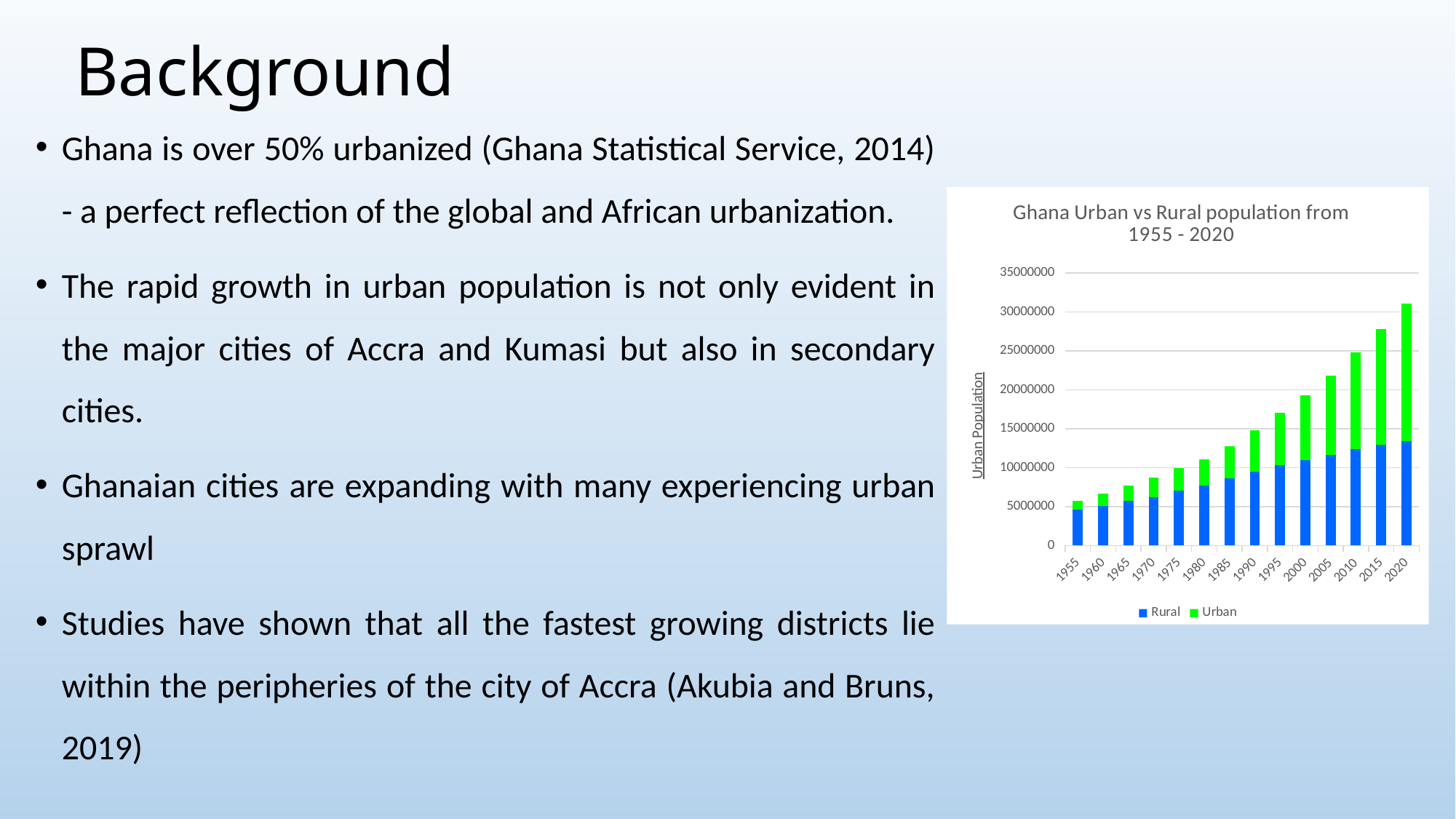
Which year has the highest total population bar in the chart? 2020 What is the title of the chart? Ghana Urban vs Rural population from 1955 - 2020 How many series does the chart's legend list? 2 What kind of chart is shown on the slide? Stacked bar chart Do the total population bars rise or fall from 1955 to 2020? Rise Is the total population bar for 2020 greater or less than 30000000? greater Is the Rural population for 2020 greater or less than 10000000? greater How many years are shown along the x axis of the chart? 14 Which colour represents the Urban series in the chart? Green Is the total population bar for 2005 greater or less than 20000000? greater Which year has the lowest total population bar in the chart? 1955